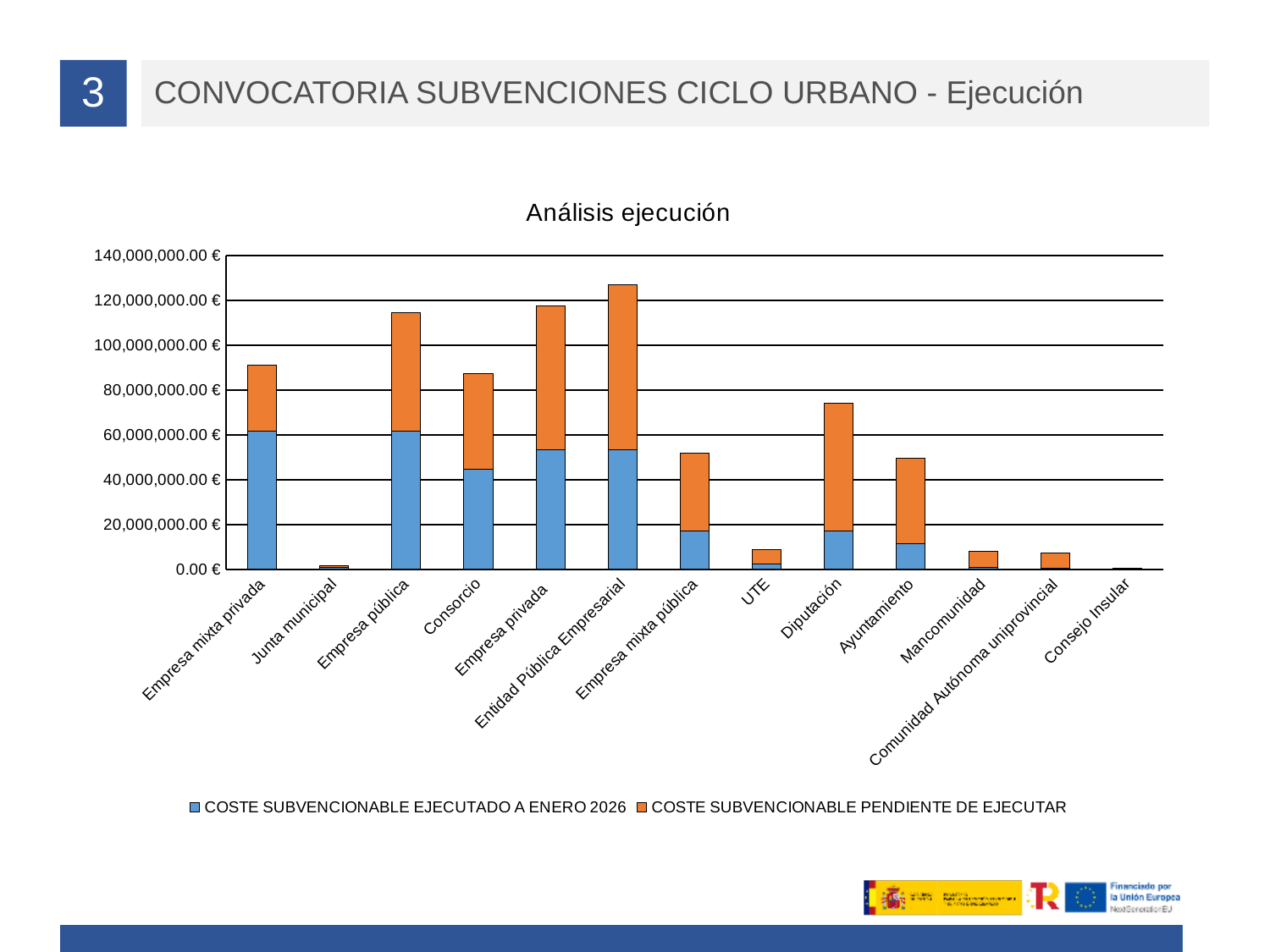
Which has the larger total bar, Diputación or Ayuntamiento? Diputación How many series does the legend list? 2 Which has the larger total bar, Empresa mixta pública or UTE? Empresa mixta pública How many categories are shown on the x axis of the chart? 13 Is the total value for UTE greater or less than 20,000,000.00 €? less What kind of chart is shown on the slide? Stacked bar chart What is the title of the chart? Análisis ejecución Is the total value for Entidad Pública Empresarial greater or less than 120,000,000.00 €? greater Is the total value for Diputación greater or less than 80,000,000.00 €? less Which series is shown in orange in the chart? COSTE SUBVENCIONABLE PENDIENTE DE EJECUTAR Which category has the highest total bar in the chart? Entidad Pública Empresarial